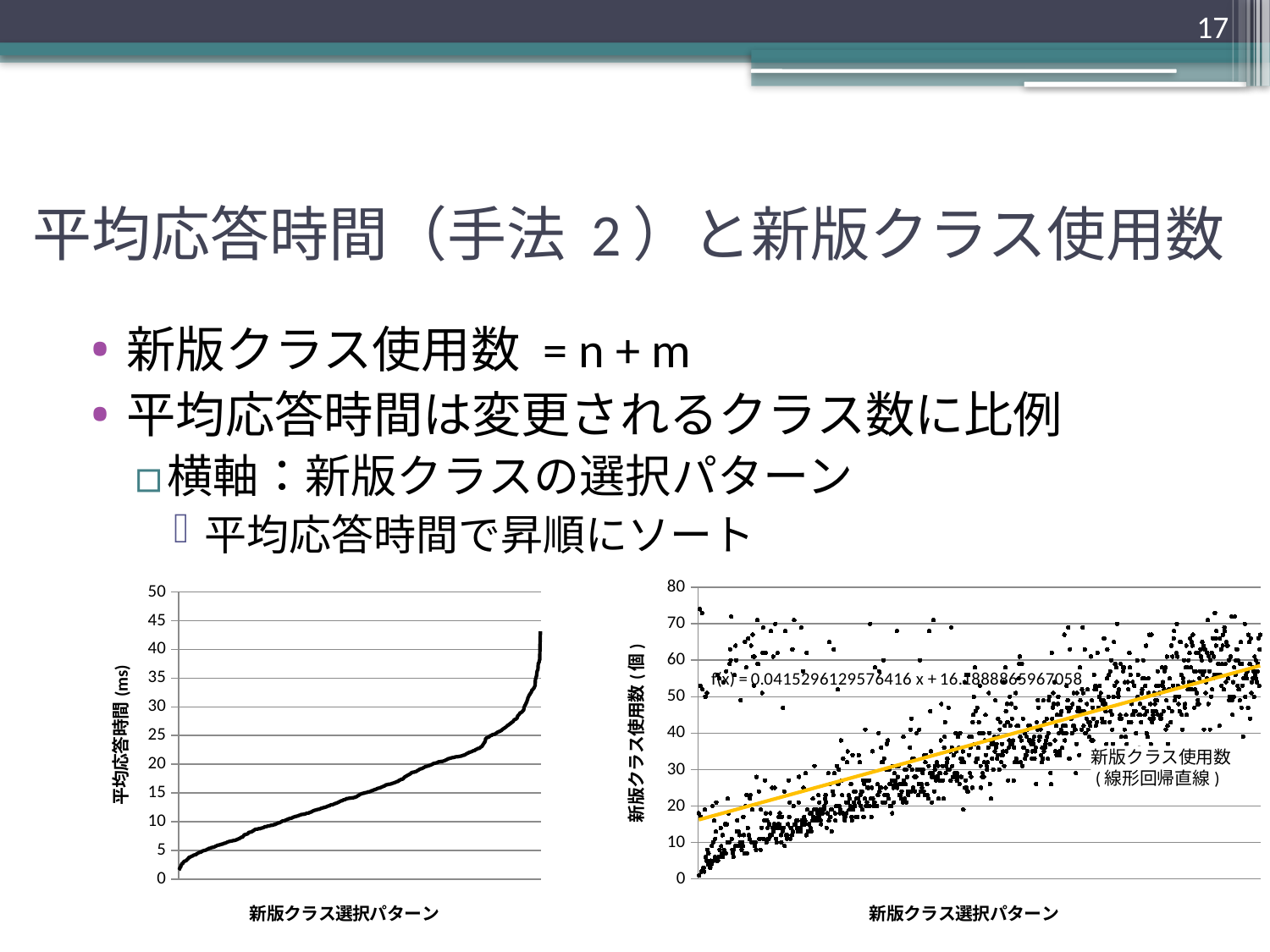
What kind of chart is the left chart (平均応答時間 vs 新版クラス選択パターン)? line chart In the left chart, do the values rise or fall along the x axis? rise In the right chart, does the regression line rise or fall along the x axis? rise In the left chart, is the highest value at the right end greater or less than 40? greater In the left chart, is the lowest value at the left end greater or less than 5? less What is the highest tick value on the y axis of the right chart? 80 In the right chart, is the regression line's value at the left end greater or less than 20? less What kind of chart is the right chart (新版クラス使用数 vs 新版クラス選択パターン)? scatter chart What is the highest tick value on the y axis of the left chart? 50